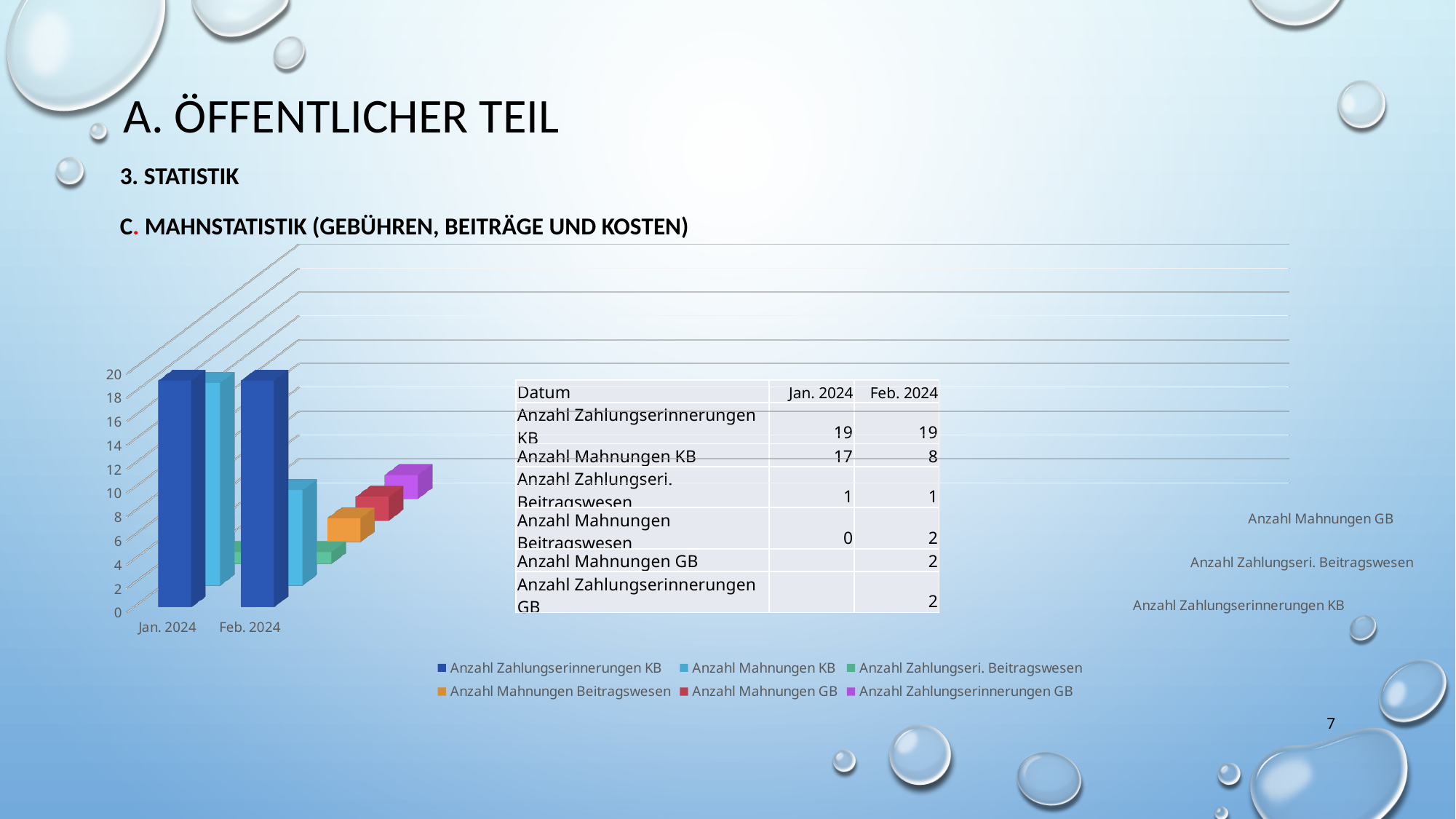
By how much did Anzahl Mahnungen KB decrease from Jan. 2024 to Feb. 2024? 9 What is the value for Anzahl Mahnungen KB in Jan. 2024? 17 Does Anzahl Mahnungen KB rise or fall from Jan. 2024 to Feb. 2024? fall What is the value for Anzahl Mahnungen Beitragswesen in Feb. 2024? 2 How many series does the legend list? 6 How many date categories are shown on the x axis? 2 Which series has the highest value in Feb. 2024? Anzahl Zahlungserinnerungen KB What is the value for Anzahl Mahnungen KB in Feb. 2024? 8 What is the value for Anzahl Zahlungserinnerungen KB in Jan. 2024? 19 What kind of chart is shown on the slide? bar chart Is the value for Anzahl Zahlungserinnerungen KB in Jan. 2024 greater or less than 10? greater Which colour represents Anzahl Mahnungen GB in the legend? red